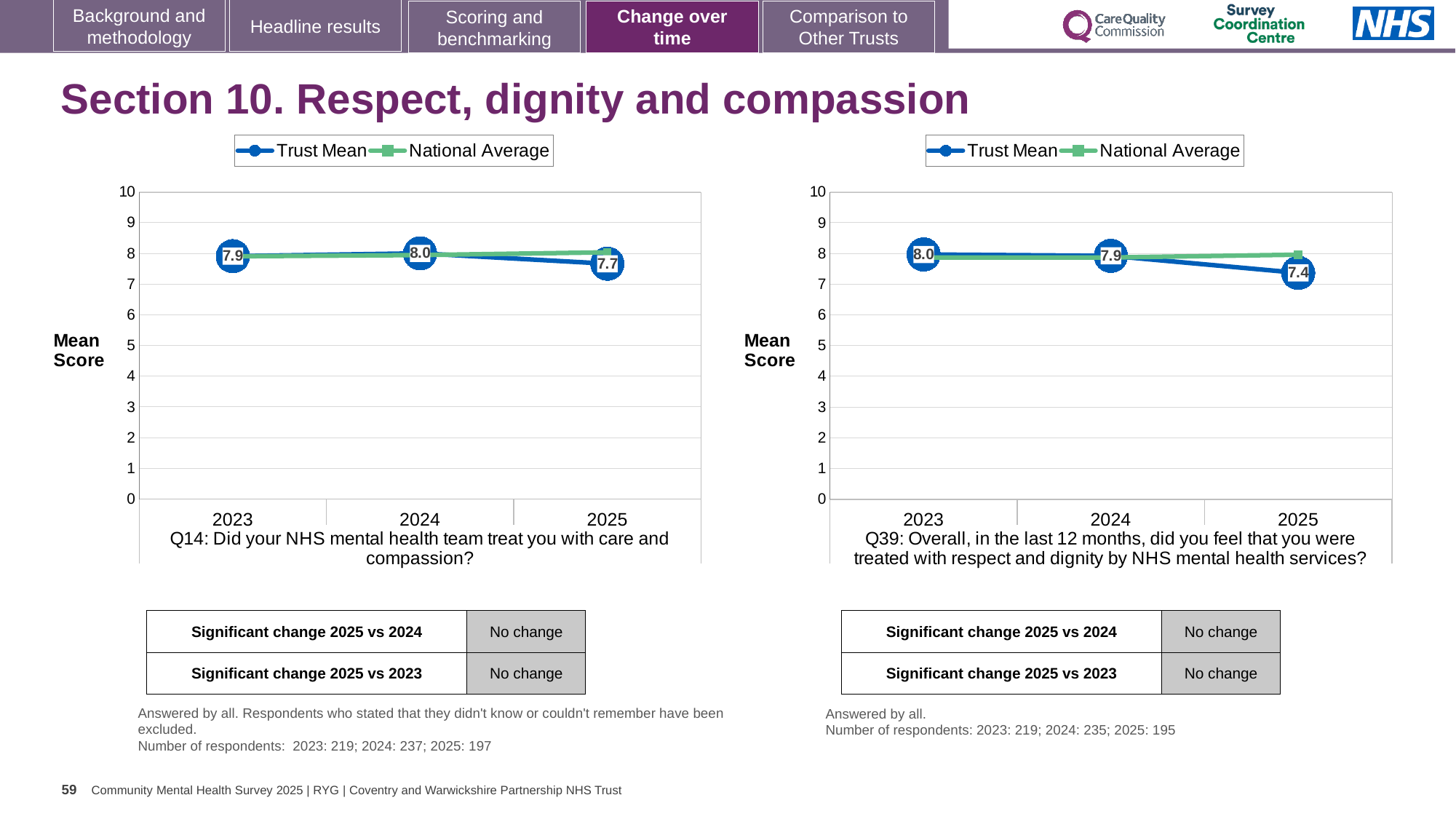
On the Q39 chart (right), which year has the lowest Trust Mean? 2025 On the Q39 chart (right), what is the Trust Mean for 2023? 8.0 On the Q39 chart (right), what is the Trust Mean for 2025? 7.4 How many series does the legend of the Q14 chart (left) list? 2 On the Q14 chart (left), what is the Trust Mean for 2024? 8.0 On the Q14 chart (left), which year has the highest Trust Mean? 2024 On the Q39 chart (right), what is the difference between the Trust Mean in 2023 and in 2025? 0.6 Which is larger: the 2025 Trust Mean on the Q14 chart (left) or the 2025 Trust Mean on the Q39 chart (right)? Q14 chart (7.7) On the Q39 chart (right), is the National Average for 2025 greater or less than 7? greater What type of chart is the Q39 chart (right)? Line chart On the Q14 chart (left), what is the difference between the Trust Mean in 2024 and in 2025? 0.3 On the Q14 chart (left), what is the Trust Mean for 2025? 7.7